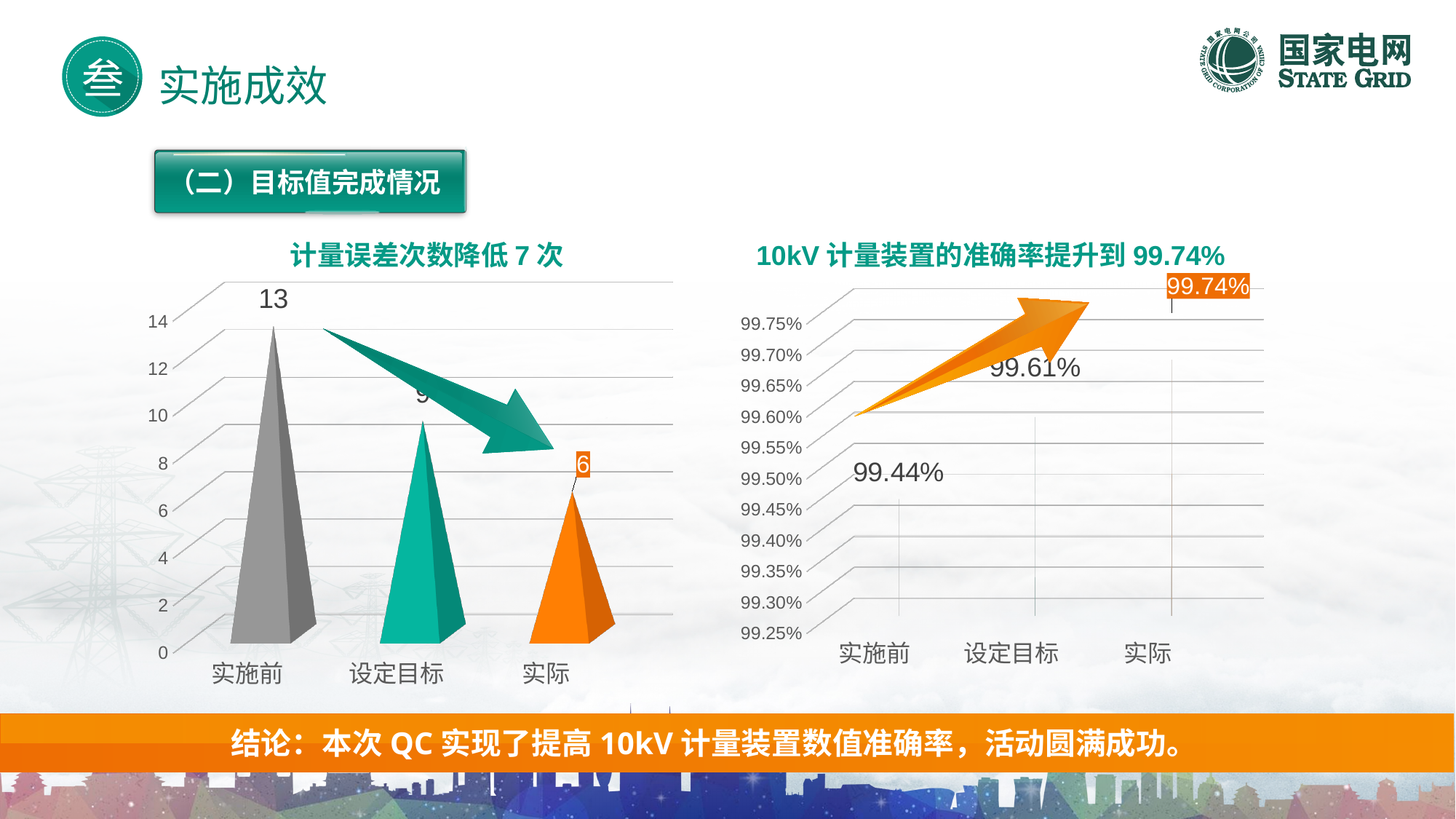
In the chart titled 计量误差次数降低 7 次, is the value for 设定目标 greater or less than 8? greater How many categories are shown on the x axis of the chart titled 10kV 计量装置的准确率提升到 99.74%? 3 In the chart titled 计量误差次数降低 7 次, which category has the highest value? 实施前 In the chart titled 计量误差次数降低 7 次, what is the value for 实际? 6 In the chart titled 计量误差次数降低 7 次, what is the difference between the values for 实施前 and 实际? 7 In the chart titled 10kV 计量装置的准确率提升到 99.74%, which category has the highest value? 实际 In the chart titled 10kV 计量装置的准确率提升到 99.74%, what is the value for 设定目标? 99.61% In the chart titled 10kV 计量装置的准确率提升到 99.74%, what is the value for 实施前? 99.44% In the chart titled 计量误差次数降低 7 次, do the values rise or fall from left to right along the x axis? fall In the chart titled 计量误差次数降低 7 次, which category has the lowest value? 实际 In the chart titled 10kV 计量装置的准确率提升到 99.74%, which is larger, the value for 实际 or the value for 设定目标? 实际 In the chart titled 计量误差次数降低 7 次, what is the value for 实施前? 13